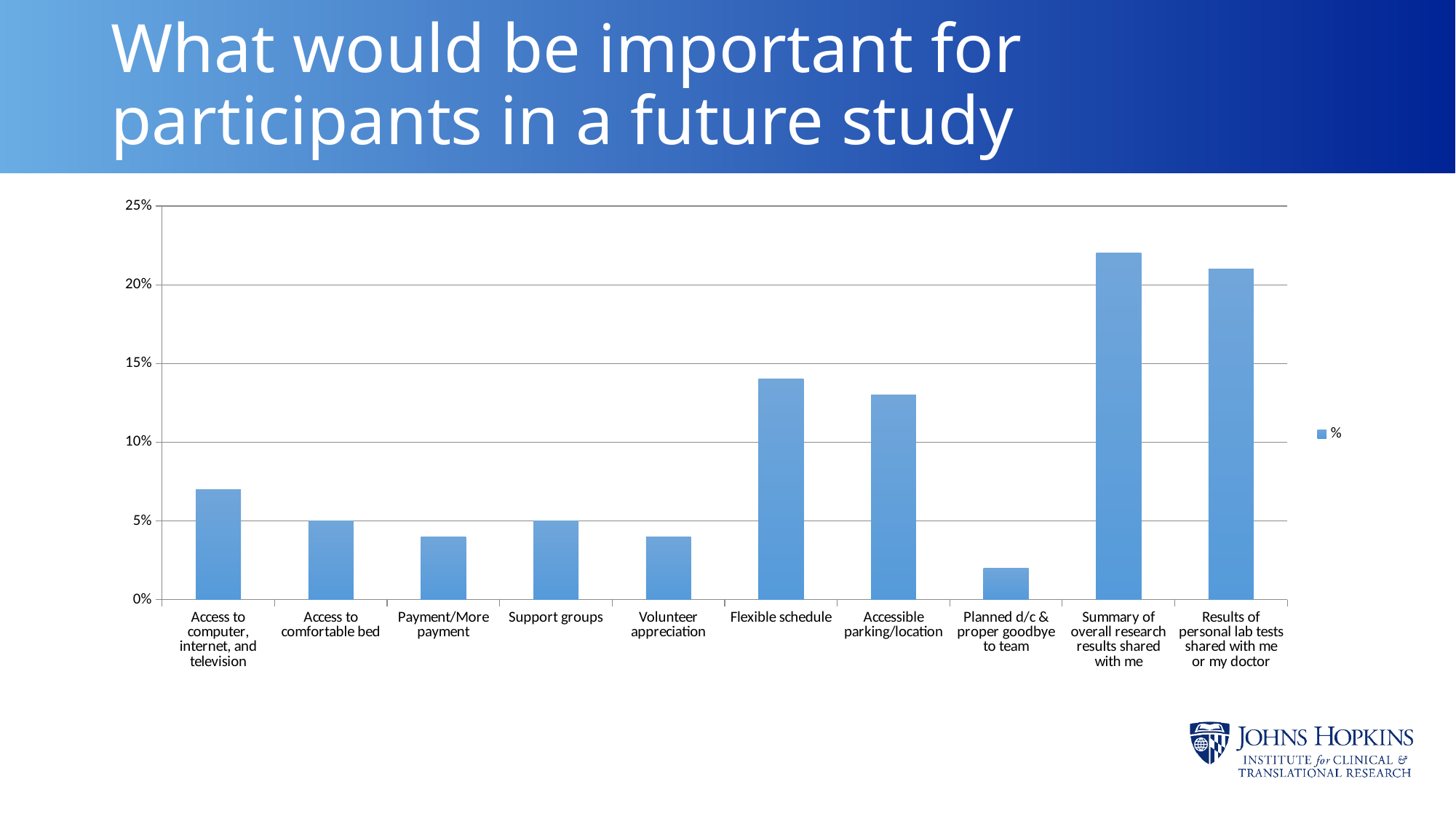
What is the entry shown in the chart's legend? % Is the value for Flexible schedule greater or less than 10%? greater Which category has the lowest value? Planned d/c & proper goodbye to team Which category has the highest value? Summary of overall research results shared with me How many series does the chart's legend list? 1 What is the value for Access to comfortable bed? 5% Is the value for Planned d/c & proper goodbye to team greater or less than 5%? less Is the value for Results of personal lab tests shared with me or my doctor greater or less than 20%? greater How many categories are shown on the x axis of the chart? 10 What kind of chart is shown on the slide? bar chart Which is larger, the value for Flexible schedule or the value for Access to computer, internet, and television? Flexible schedule What is the value for Support groups? 5%